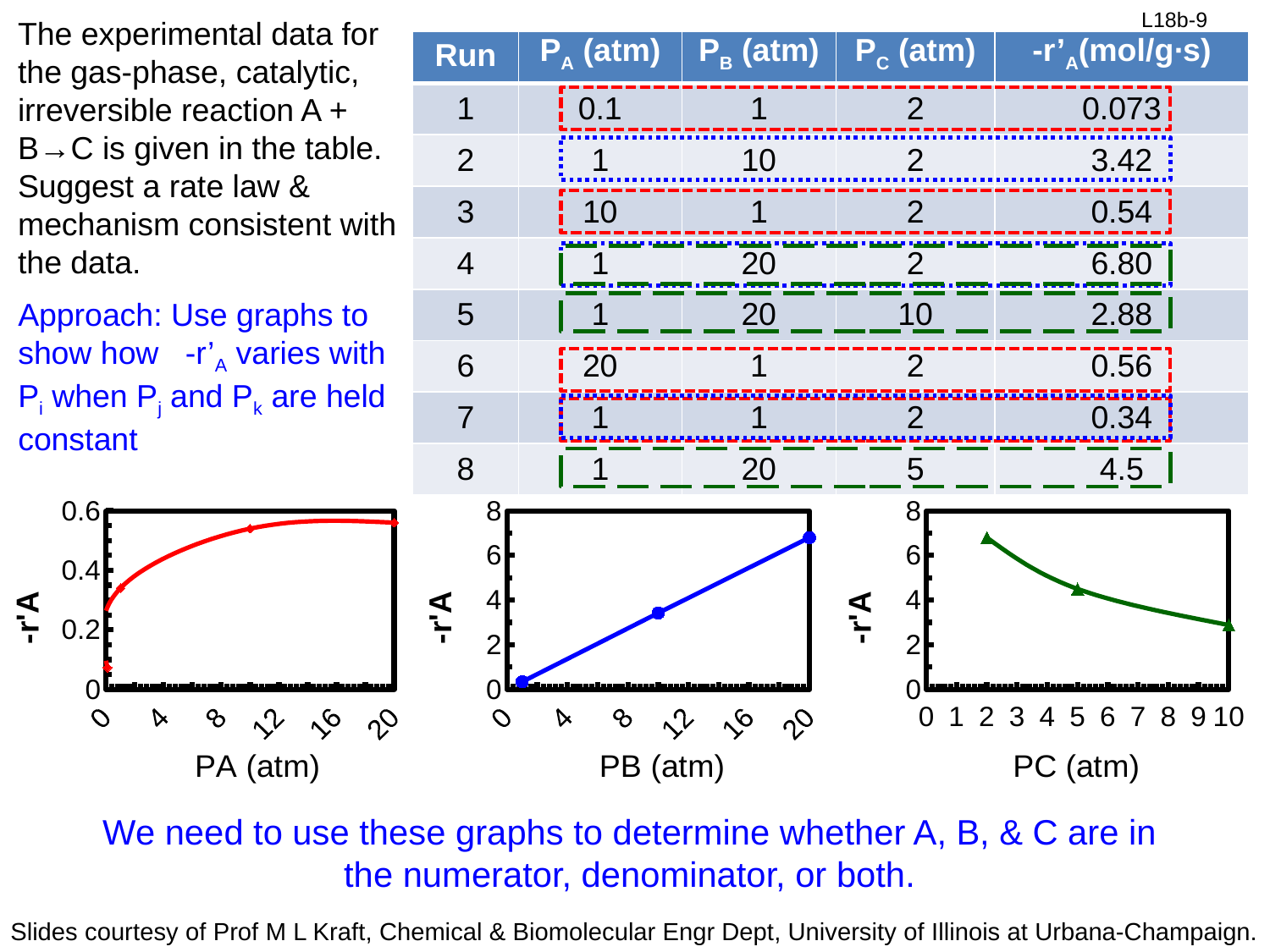
What kind of chart is the middle chart with x-axis PB (atm)? line chart In the middle chart with x-axis PB (atm), how many data points are plotted? 3 In the middle chart with x-axis PB (atm), is the value of -r'A at PB = 20 greater or less than 6? greater In the right chart with x-axis PC (atm), at which PC value is -r'A highest? 2 In the right chart with x-axis PC (atm), is the value of -r'A at PC = 10 greater or less than 4? less What is the x-axis label of the left chart? PA (atm) In the middle chart with x-axis PB (atm), which has the larger -r'A: the point at PB = 10 or the point at PB = 20? PB = 20 In the middle chart with x-axis PB (atm), does -r'A rise or fall as PB increases? rise In the right chart with x-axis PC (atm), how many data points are plotted? 3 In the right chart with x-axis PC (atm), does -r'A rise or fall as PC increases? fall In the left chart with x-axis PA (atm), how many data points are plotted? 4 In the left chart with x-axis PA (atm), is the value of -r'A at PA = 10 greater or less than 0.4? greater